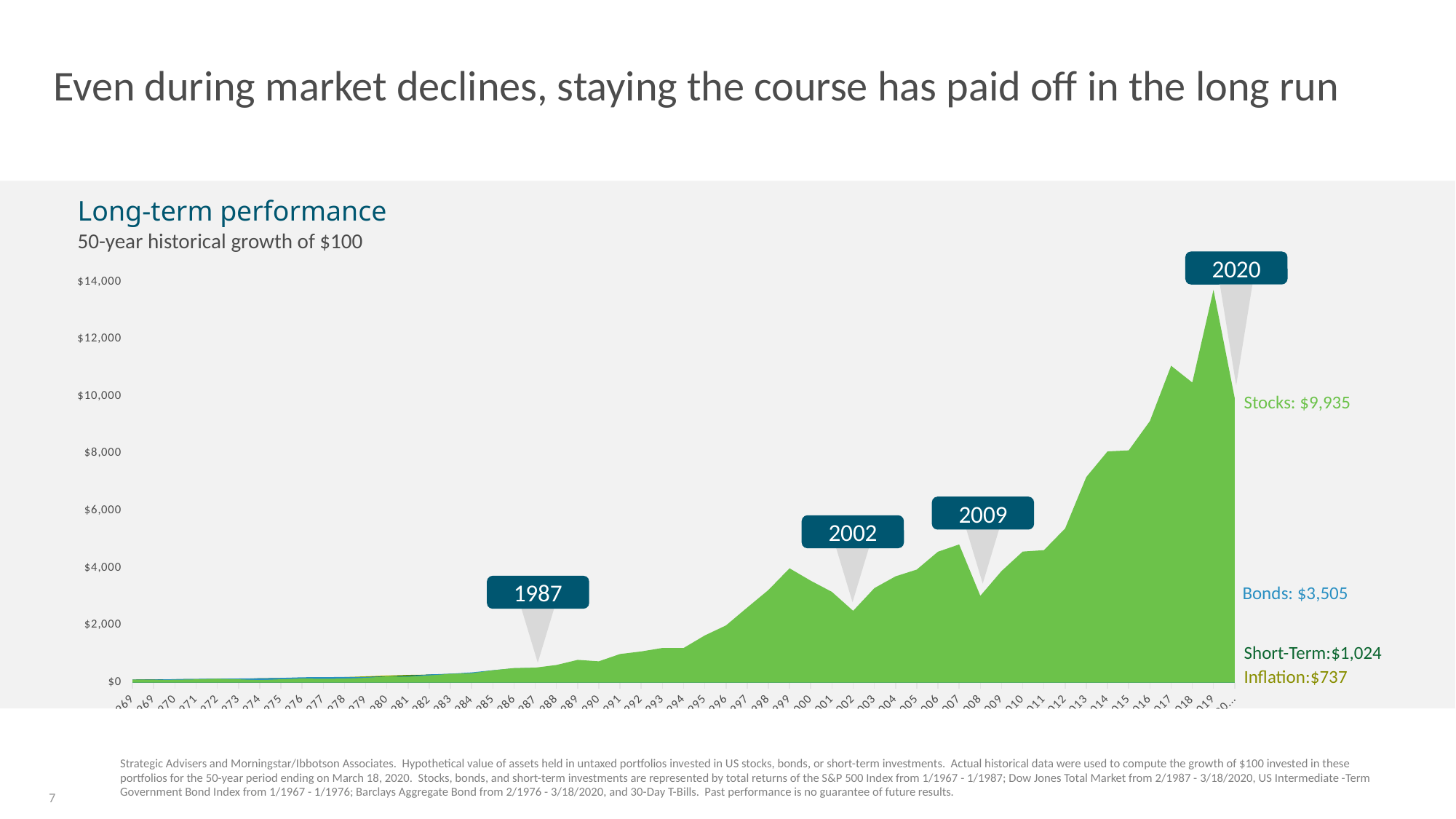
How many years are highlighted with callout labels on the chart? 4 Which series has the highest ending value? Stocks What is the ending value shown for Stocks? $9,935 What kind of chart is shown on the slide? Area chart What is the ending value shown for Inflation? $737 What is the title of the chart? Long-term performance What is the difference between the ending values of Stocks and Bonds? $6,430 What is the ending value shown for Bonds? $3,505 What is the ending value shown for Short-Term? $1,024 Which series has the lowest ending value? Inflation Which has a larger ending value, Bonds or Short-Term? Bonds Is the peak value of the Stocks series just before the 2020 decline greater or less than $12,000? greater